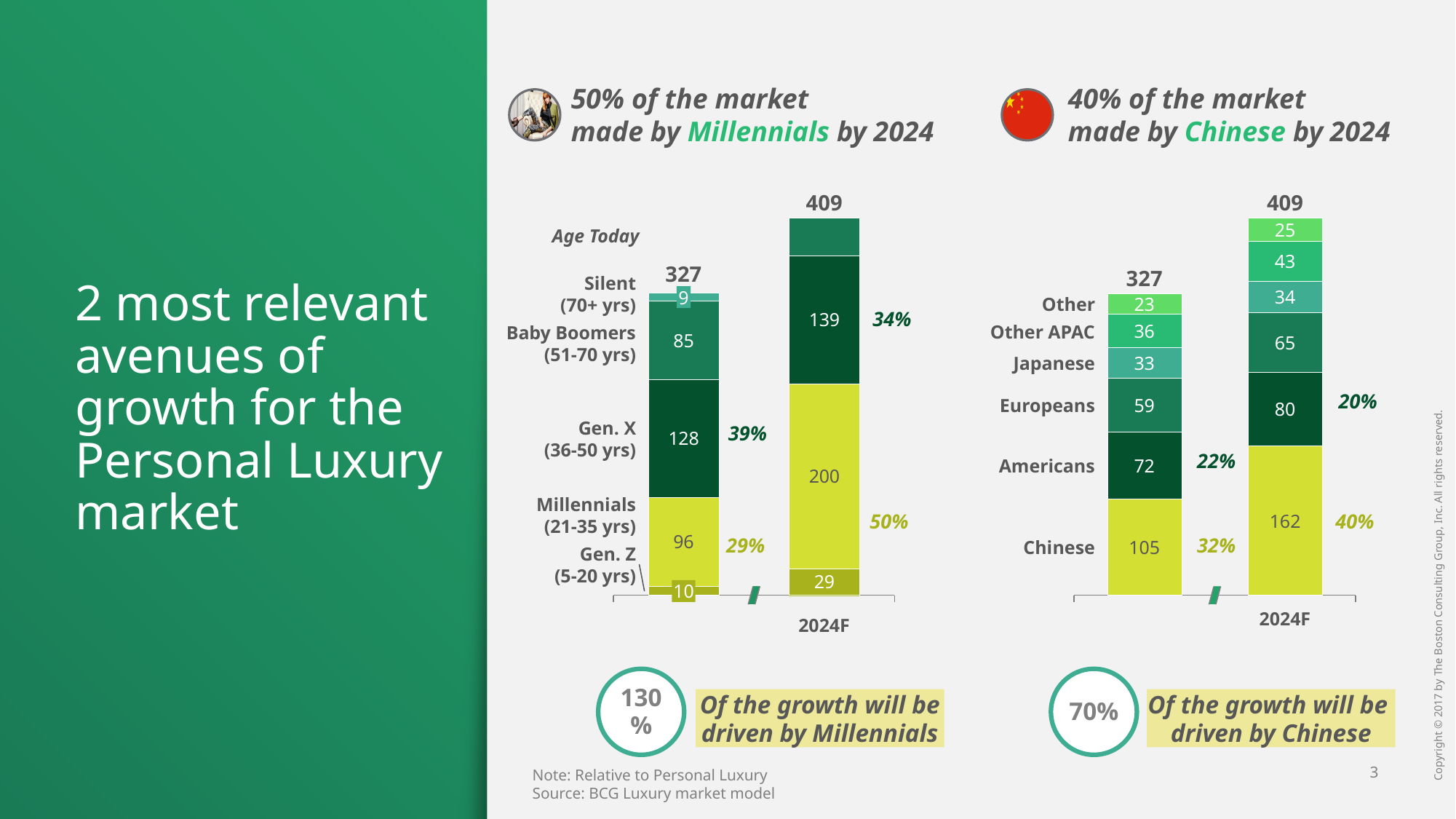
What type of chart is used on the slide? Stacked bar chart In the right chart (nationalities), which nationality has the largest value in the first bar? Chinese In the left chart (age groups), what is the value for Millennials (21-35 yrs) in the 2024F bar? 200 In the left chart (age groups), what is the total of the 2024F stacked bar? 409 In the left chart (age groups), which age group has the smallest value in the first bar? Silent (70+ yrs) In the right chart (nationalities), what is the difference between the Chinese value in the 2024F bar (162) and in the first bar (105)? 57 In the left chart (age groups), what is the value for Gen. X (36-50 yrs) in the first bar? 128 In the right chart (nationalities), how many nationality categories are listed? 6 In the left chart (age groups), what is the difference between the Gen. X value (128) and the Millennials value (96) in the first bar? 32 In the right chart (nationalities), what is the value for Europeans in the first bar? 59 In the right chart (nationalities), which is larger in the first bar: Americans or Europeans? Americans In the right chart (nationalities), what is the value for Chinese in the 2024F bar? 162